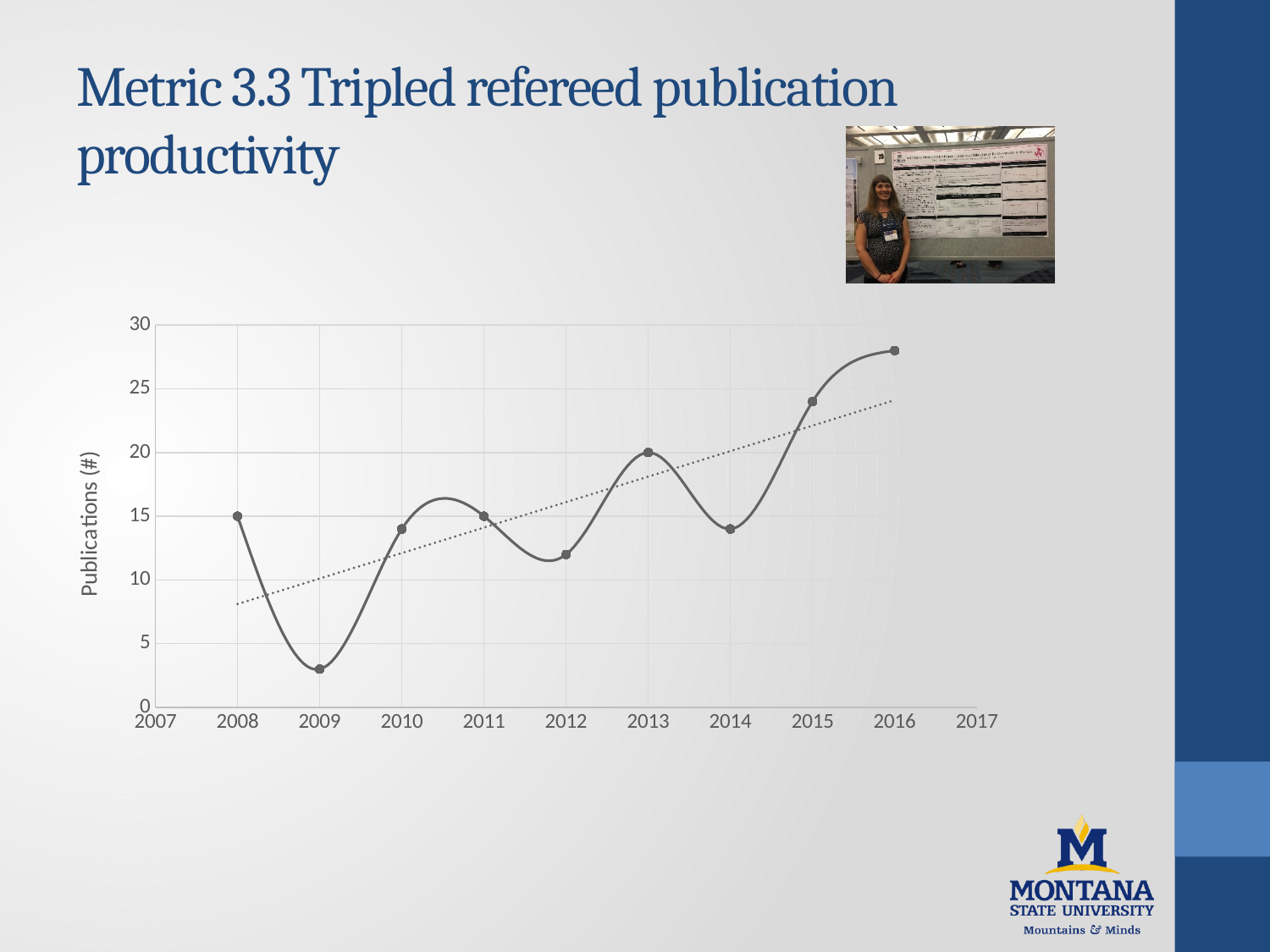
How many publications are shown for 2013? 20 What is the label on the vertical axis? Publications (#) Which year has the lowest number of publications? 2009 Is the value for 2009 greater or less than 5? less What type of chart is shown on the slide? line chart Which year has more publications, 2015 or 2014? 2015 Which year has the highest number of publications? 2016 Is the value for 2015 greater or less than 20? greater How many data points are plotted on the chart? 9 How many publications are shown for 2008? 15 Is the value for 2016 greater or less than 25? greater Do publications generally rise or fall from 2008 to 2016? rise